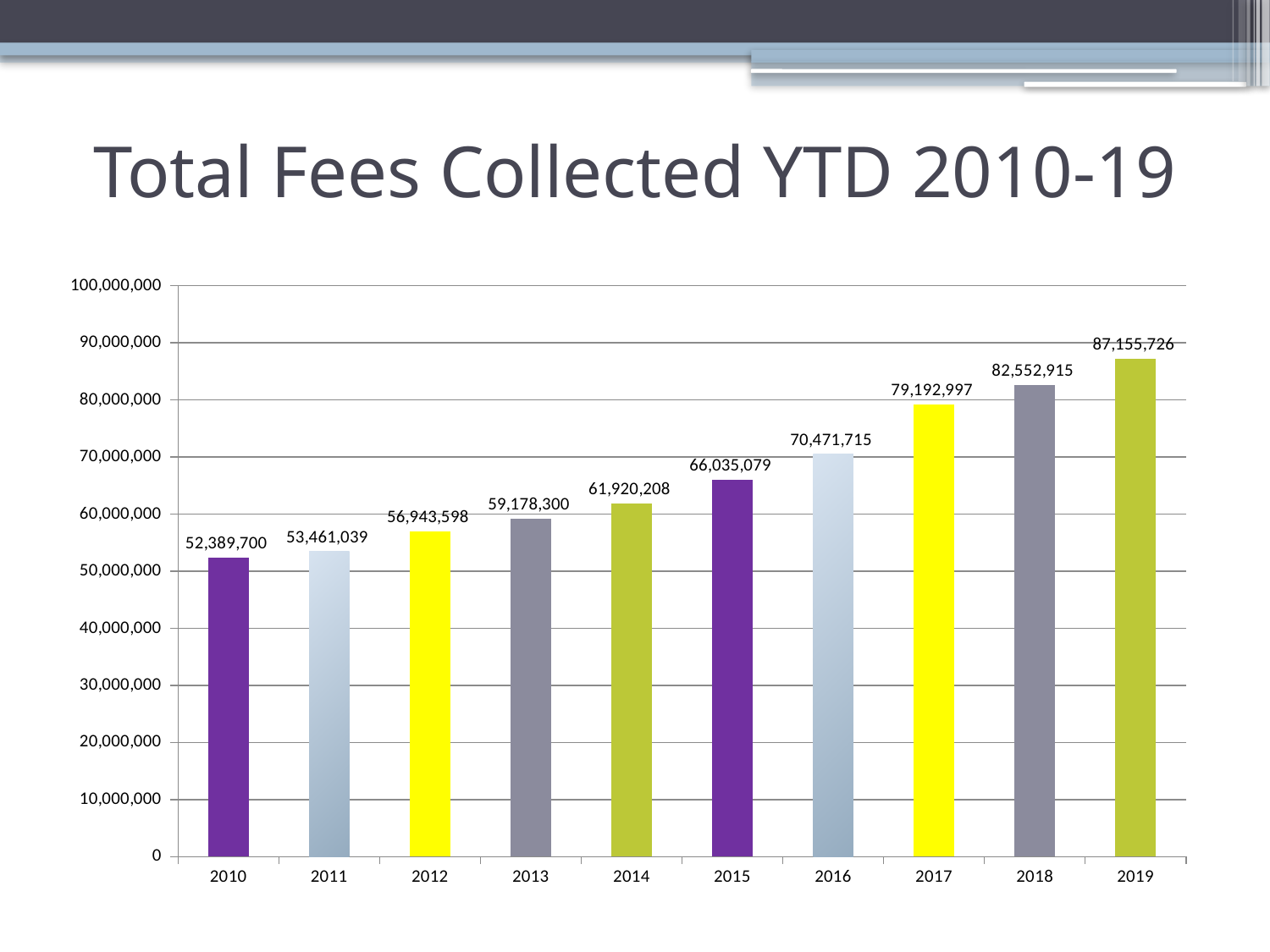
What kind of chart is shown on the slide? bar chart Do the values rise or fall from 2010 to 2019? rise Is the value for 2017 greater or less than 80,000,000? less How many years are shown on the x axis? 10 Which is larger, the value for 2014 or the value for 2015? 2015 Which year has the highest value? 2019 What is the value for 2016? 70,471,715 What is the value for 2013? 59,178,300 What is the difference between the values for 2018 and 2017? 3,359,918 What is the value for 2010? 52,389,700 What is the difference between the values for 2019 and 2010? 34,766,026 Which year has the lowest value? 2010